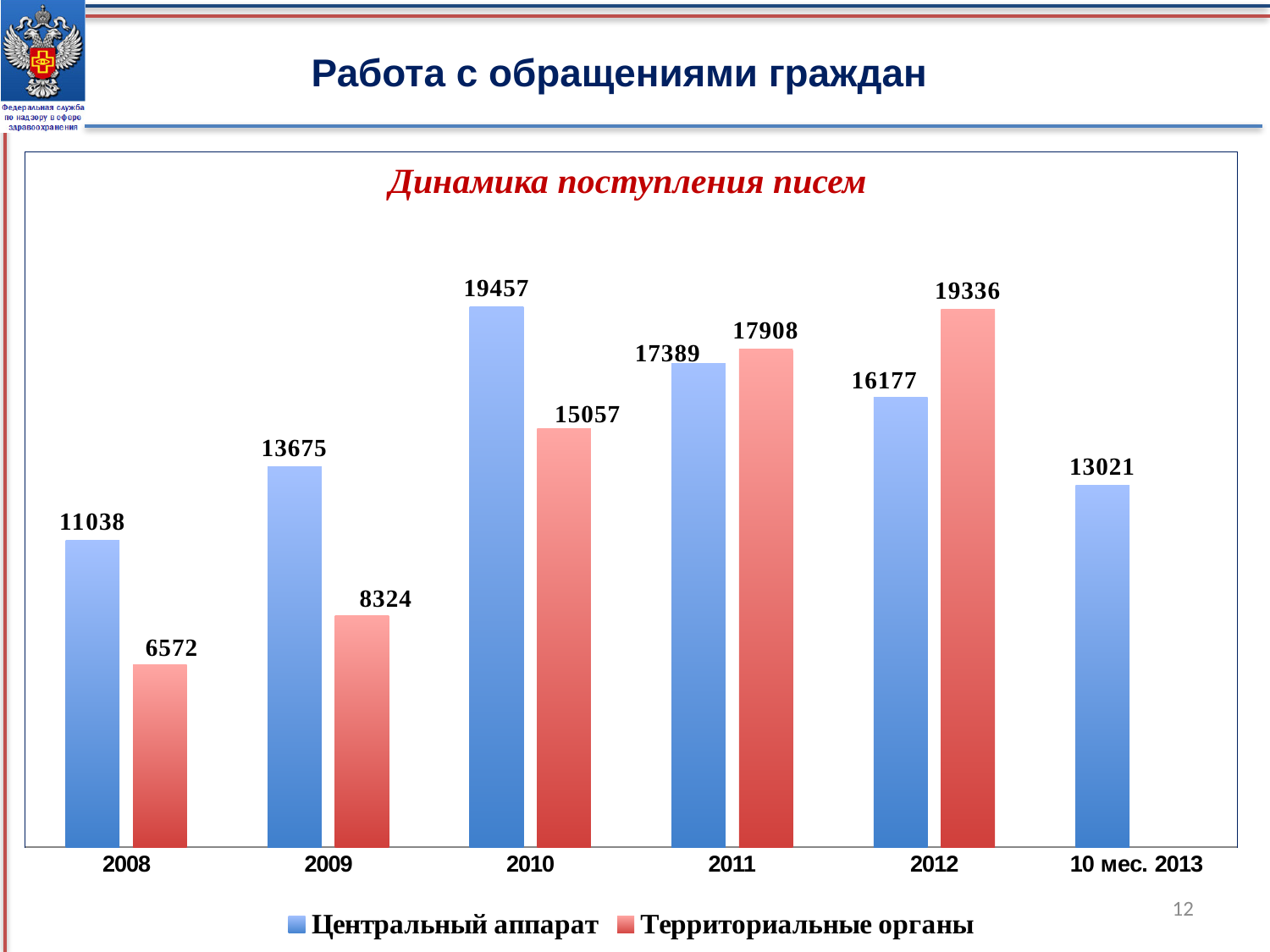
Does the value for Территориальные органы rise or fall from 2008 to 2012? rise Which is larger in 2011: Центральный аппарат or Территориальные органы? Территориальные органы What is the title of the chart? Динамика поступления писем In which year is the value for Центральный аппарат lowest? 2008 What is the value for Территориальные органы in 2008? 6572 What is the value for Центральный аппарат for 10 мес. 2013? 13021 How many categories are shown on the x axis? 6 In which year is the value for Территориальные органы highest? 2012 How many series does the legend list? 2 What is the value for Центральный аппарат in 2010? 19457 What is the difference between Центральный аппарат and Территориальные органы in 2009? 5351 What type of chart is shown on the slide? bar chart